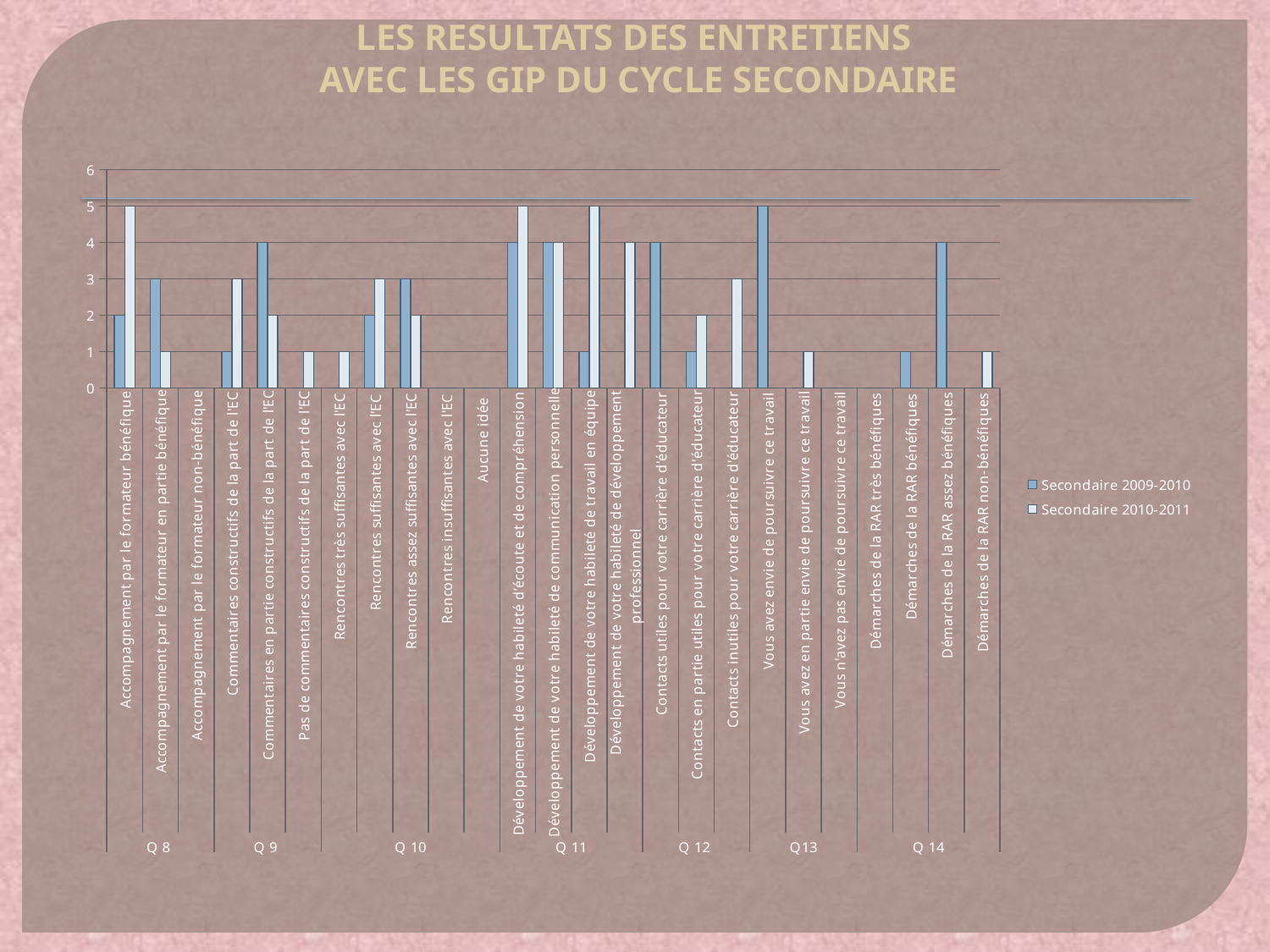
What is the value for 'Vous avez envie de poursuivre ce travail' in the Secondaire 2009-2010 series? 5 What type of chart is shown on the slide? bar chart What is the value for 'Commentaires en partie constructifs de la part de l'IEC' in the Secondaire 2009-2010 series? 4 What is the title of the slide containing the chart? LES RESULTATS DES ENTRETIENS AVEC LES GIP DU CYCLE SECONDAIRE What is the value for 'Développement de votre habileté de développement professionnel' in the Secondaire 2010-2011 series? 4 How many series does the legend list? 2 Is the Secondaire 2009-2010 value for 'Démarches de la RAR assez bénéfiques' greater or less than 2? greater What is the difference between the Secondaire 2010-2011 and Secondaire 2009-2010 values for 'Développement de votre habileté de travail en équipe'? 4 For 'Contacts utiles pour votre carrière d'éducateur', which series has the larger value, Secondaire 2009-2010 or Secondaire 2010-2011? Secondaire 2009-2010 How many question groups (Q labels) are shown along the x axis? 7 For 'Rencontres suffisantes avec l'IEC', which series has the larger value, Secondaire 2009-2010 or Secondaire 2010-2011? Secondaire 2010-2011 What is the value for 'Accompagnement par le formateur bénéfique' in the Secondaire 2010-2011 series? 5